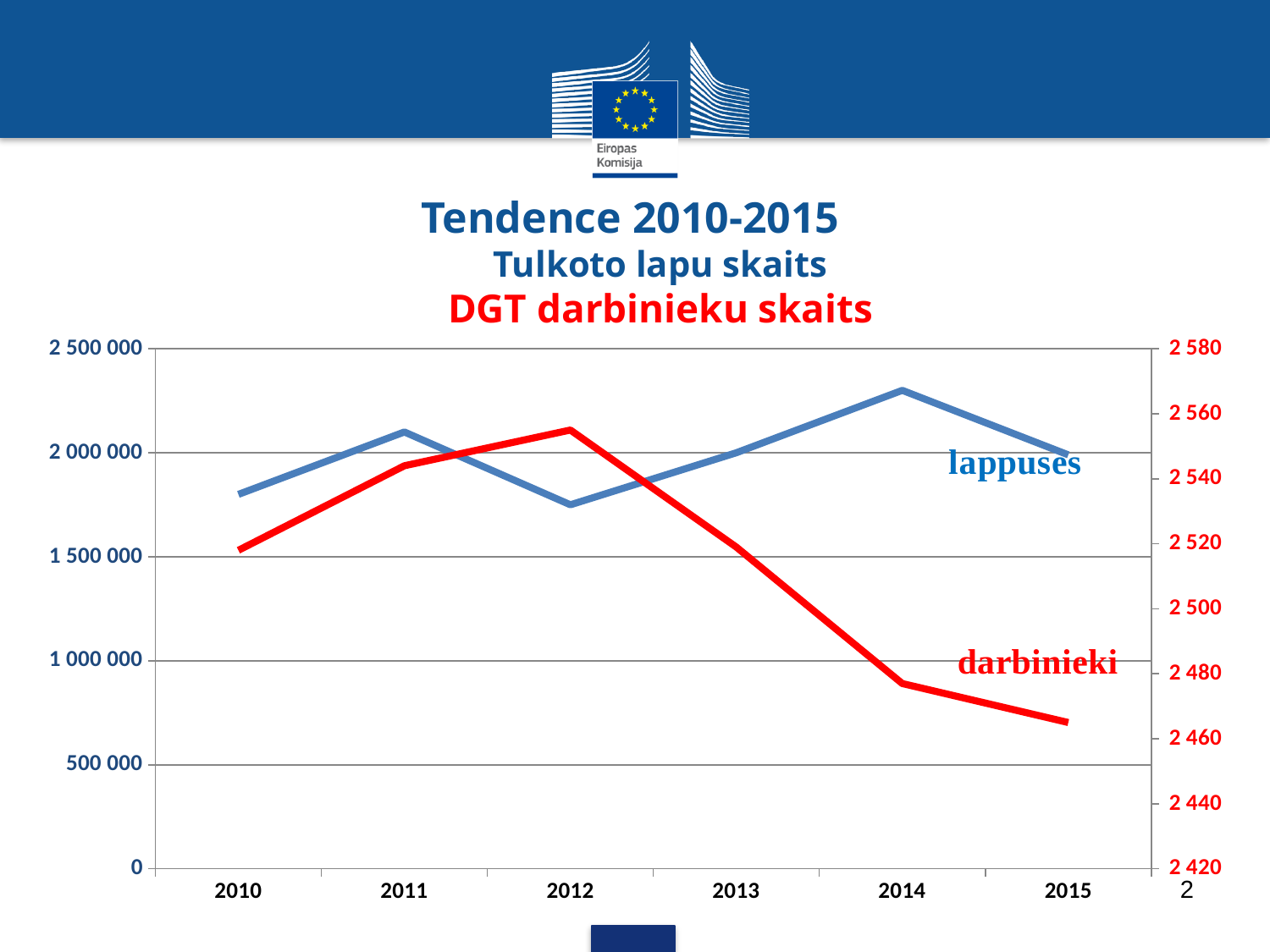
Is the value for lappuses in 2014 greater or less than 2 000 000? greater How many data series are labelled on the chart? 2 In which year does the lappuses series reach its highest value? 2014 Does the darbinieki series rise or fall from 2012 to 2015? fall Is the value for darbinieki in 2015 greater or less than 2 480? less In which year does the darbinieki series reach its highest value? 2012 Which is larger for lappuses: the value in 2014 or the value in 2012? 2014 How many years are plotted along the x axis of the chart? 6 Is the value for darbinieki in 2012 greater or less than 2 540? greater In which year does the darbinieki series reach its lowest value? 2015 What kind of chart is shown on the slide? line chart